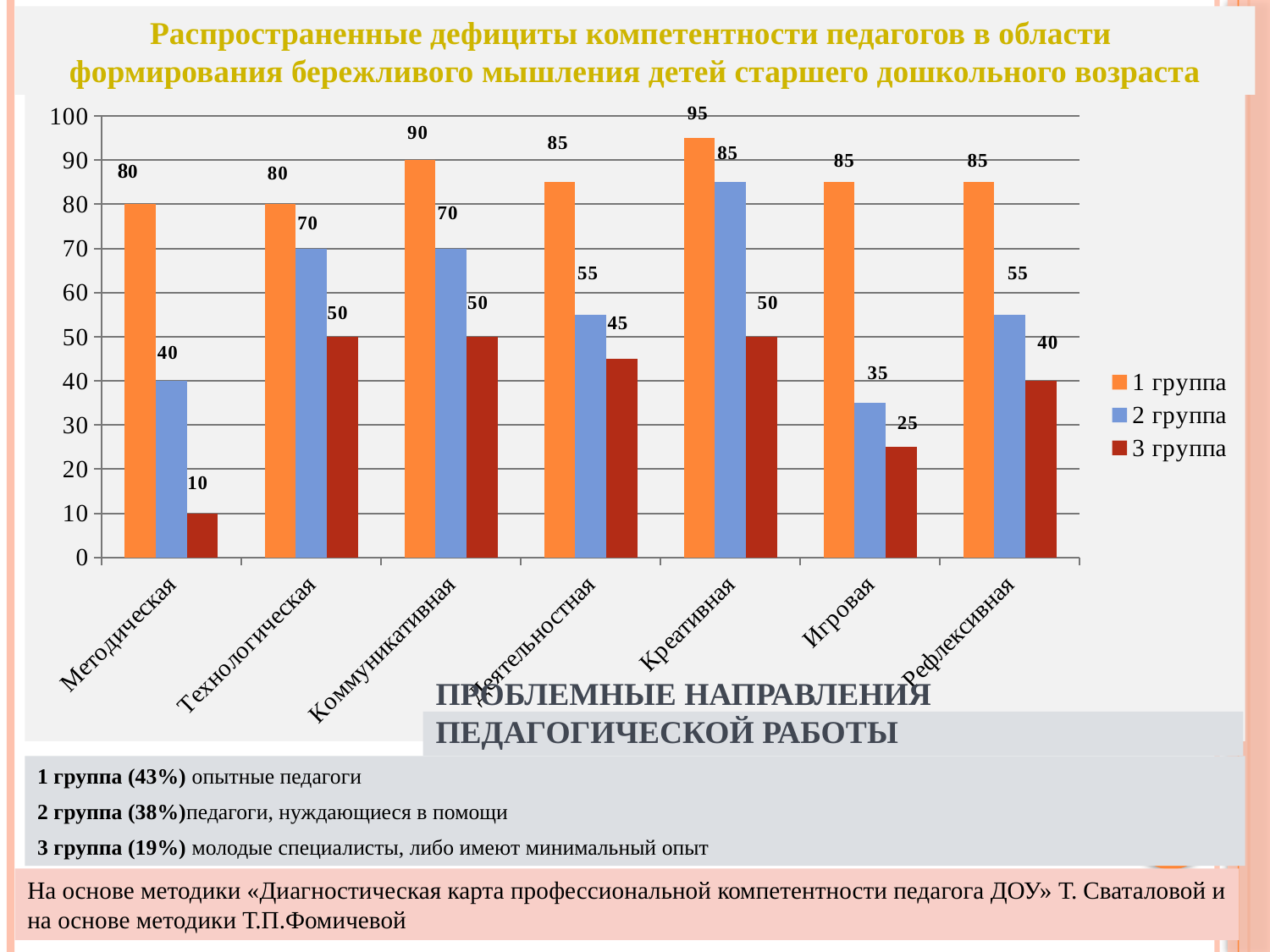
Which category has the highest value for 1 группа? Креативная What is the difference between the 1 группа and 2 группа values in the Методическая category? 40 How many categories are shown on the x axis? 7 What is the value for 3 группа in the Деятельностная category? 45 Which category has the lowest value for 3 группа? Методическая How many series does the legend list? 3 Which is larger: the 2 группа value for Креативная or the 2 группа value for Рефлексивная? Креативная What is the value for 3 группа in the Методическая category? 10 Which colour represents 3 группа in the legend? Red What kind of chart is shown on the slide? Bar chart What is the value for 2 группа in the Игровая category? 35 What is the value for 1 группа in the Креативная category? 95